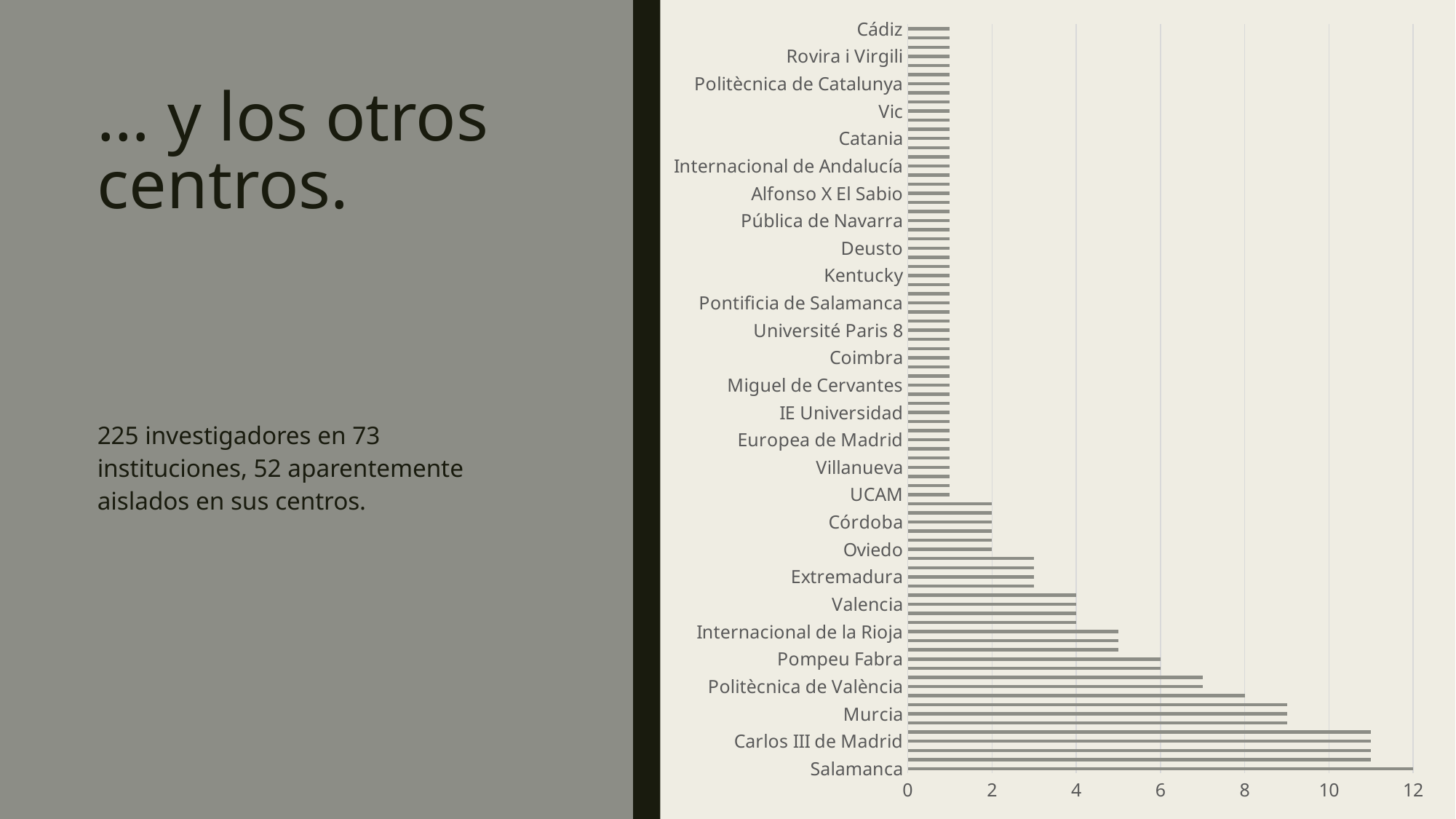
Is the value for Carlos III de Madrid greater or less than 10? greater What is the value for Oviedo? 2 What is the difference between the values for Salamanca and Valencia? 8 What is the value for Valencia? 4 What is the value for Salamanca? 12 Is the value for Murcia greater or less than 8? greater Is the value for Extremadura greater or less than 4? less What kind of chart is shown on the slide? bar chart What is the highest value shown on the horizontal axis? 12 Which institution has the highest value in the chart? Salamanca Which is larger, the value for Salamanca or the value for Murcia? Salamanca What is the value for Pompeu Fabra? 6